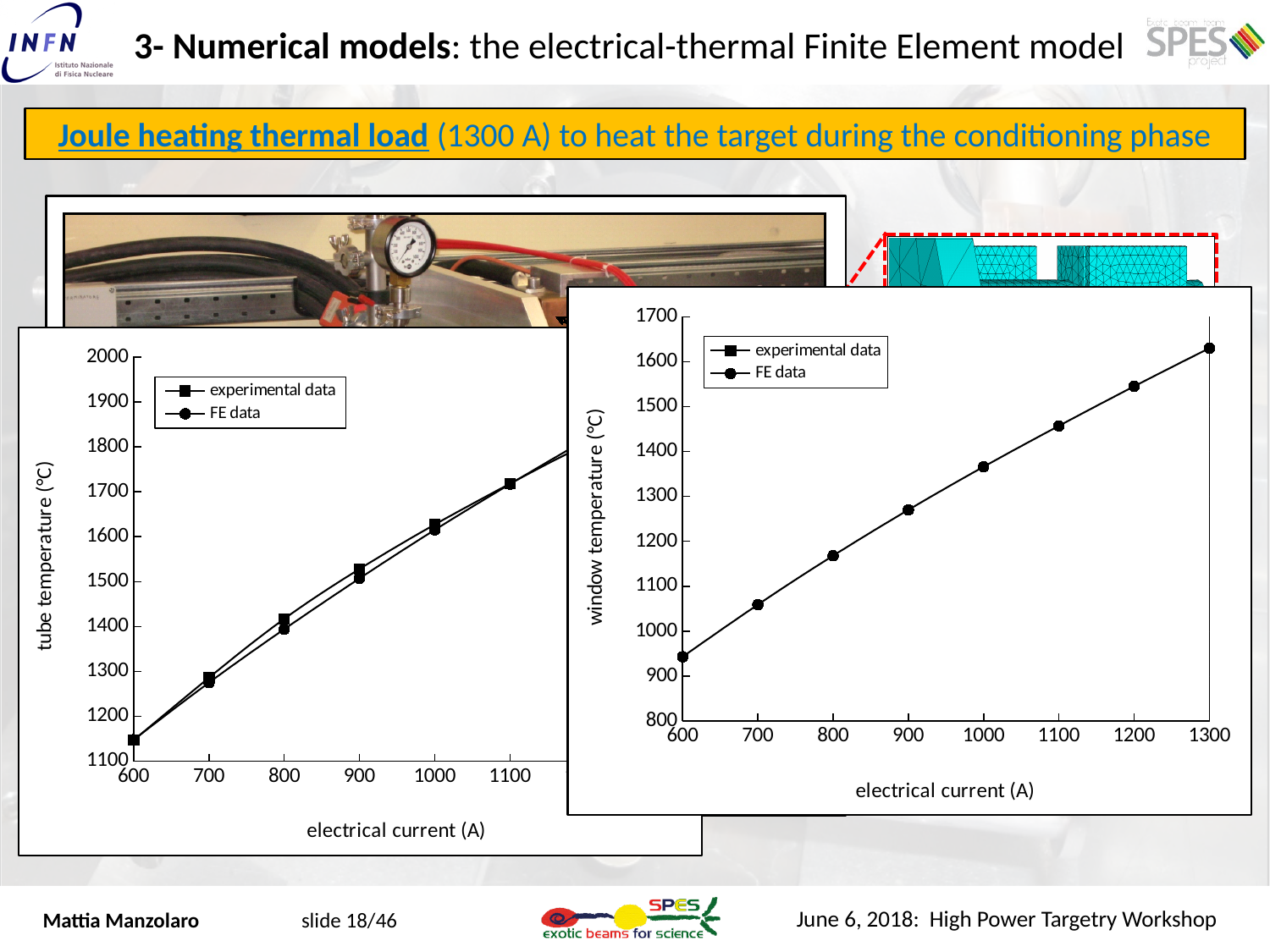
In the chart on the right (window temperature), is the value at 1300 A greater or less than 1600? greater In the chart on the right (window temperature), do the values rise or fall as electrical current increases from 600 A to 1300 A? rise In the chart on the right (window temperature), is the value at 600 A greater or less than 1000? less What kind of chart is the chart on the right with the y axis labelled 'window temperature (°C)'? line chart How many series does the legend list in the chart on the left with the y axis labelled 'tube temperature (°C)'? 2 In the chart on the left (tube temperature), do the values rise or fall as electrical current increases along the x axis? rise In the chart on the left (tube temperature), is the value at 600 A greater or less than 1200? less In the chart on the right (window temperature), at which electrical current is the window temperature highest? 1300 A In the chart on the right (window temperature), what are the two series named in the legend? experimental data and FE data